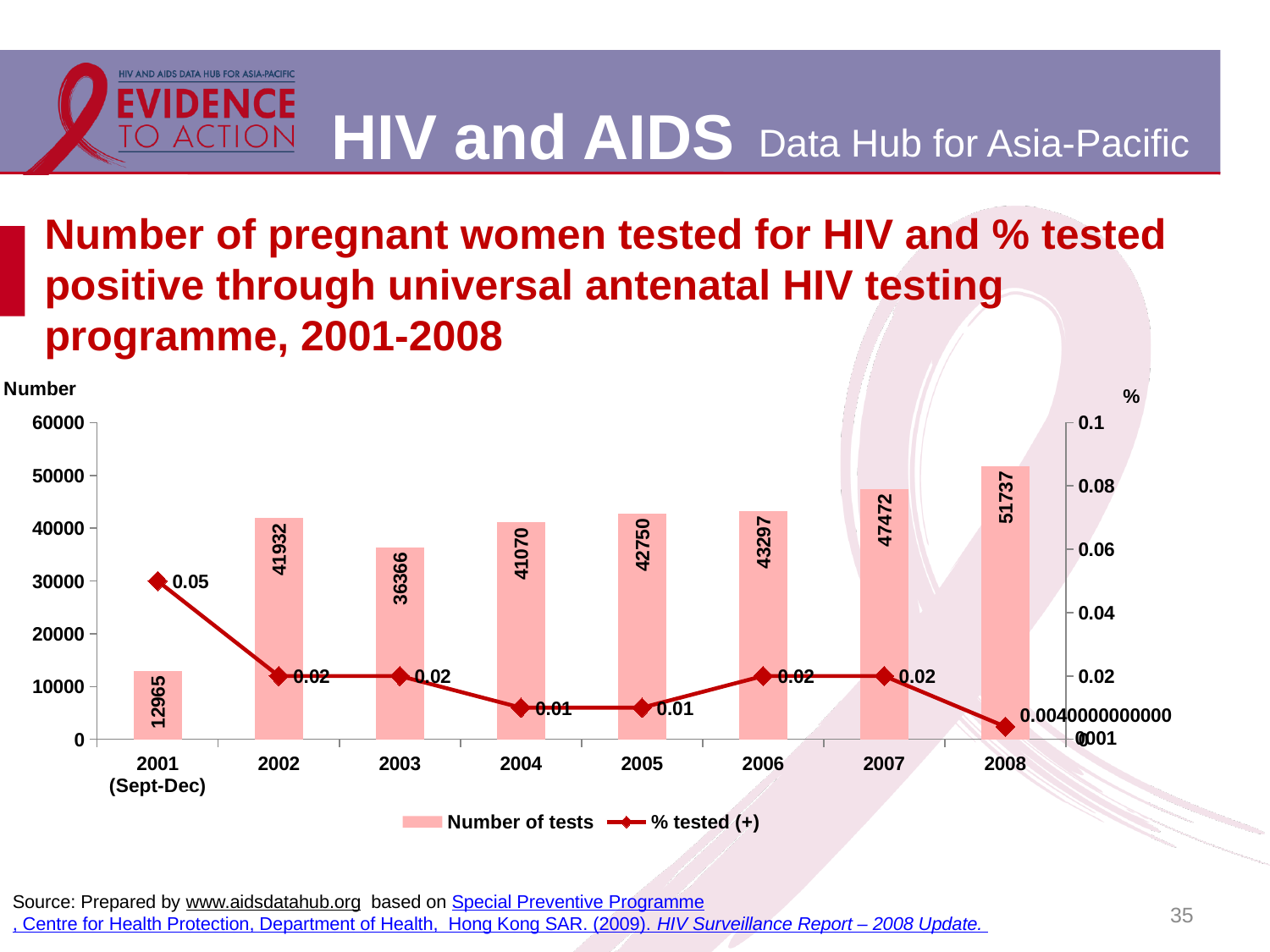
What are the two series named in the legend? Number of tests; % tested (+) What is the number of tests in 2001 (Sept-Dec)? 12965 Is the number of tests in 2006 greater or less than 40000? greater What is the number of tests in 2008? 51737 What is the difference in the number of tests between 2008 and 2007? 4265 Which year has the lowest number of tests? 2001 (Sept-Dec) Which year had more tests, 2003 or 2004? 2004 How many years are shown on the x axis? 8 What is the % tested (+) value in 2001 (Sept-Dec)? 0.05 What is the % tested (+) value in 2004? 0.01 Which year has the highest number of tests? 2008 How many series does the legend list? 2